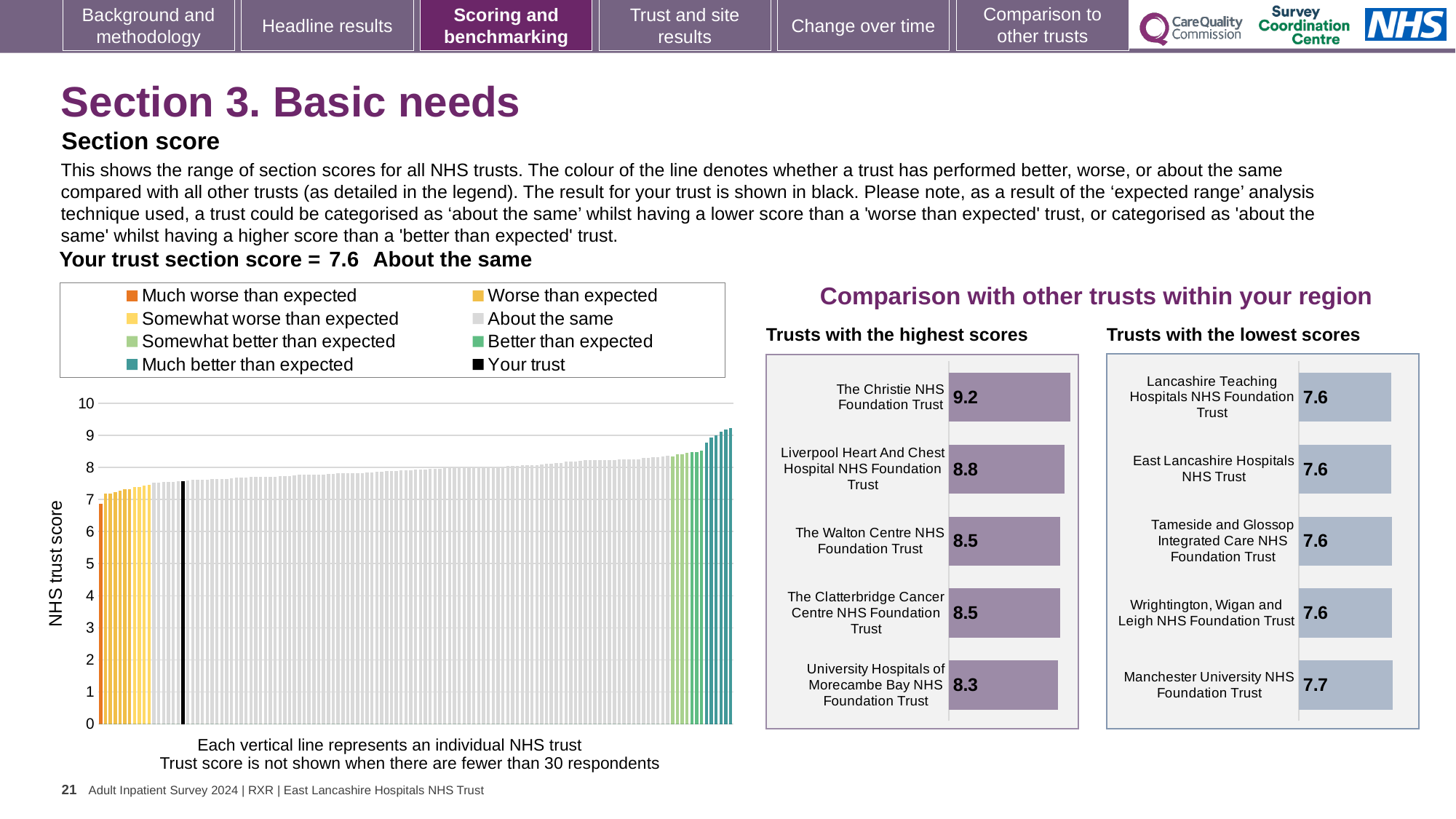
How many trusts are shown in the 'Trusts with the lowest scores' chart? 5 In the NHS trust score chart on the left, do the values rise or fall from left to right? Rise In the 'Trusts with the lowest scores' chart, what is the difference between the scores of Manchester University NHS Foundation Trust and East Lancashire Hospitals NHS Trust? 0.1 In the 'Trusts with the highest scores' chart, what is the score for The Christie NHS Foundation Trust? 9.2 In the 'Trusts with the highest scores' chart, which has the larger score: The Walton Centre NHS Foundation Trust or University Hospitals of Morecambe Bay NHS Foundation Trust? The Walton Centre NHS Foundation Trust How many entries does the legend of the NHS trust score chart on the left list? 8 In the 'Trusts with the highest scores' chart, which trust has the lowest score? University Hospitals of Morecambe Bay NHS Foundation Trust In the 'Trusts with the lowest scores' chart, which trust has the highest score? Manchester University NHS Foundation Trust In the 'Trusts with the highest scores' chart, which trust has the highest score? The Christie NHS Foundation Trust In the 'Trusts with the highest scores' chart, what is the difference between the scores of The Christie NHS Foundation Trust and Liverpool Heart And Chest Hospital NHS Foundation Trust? 0.4 In the 'Trusts with the lowest scores' chart, what is the score for Manchester University NHS Foundation Trust? 7.7 In the 'Trusts with the highest scores' chart, what is the score for University Hospitals of Morecambe Bay NHS Foundation Trust? 8.3